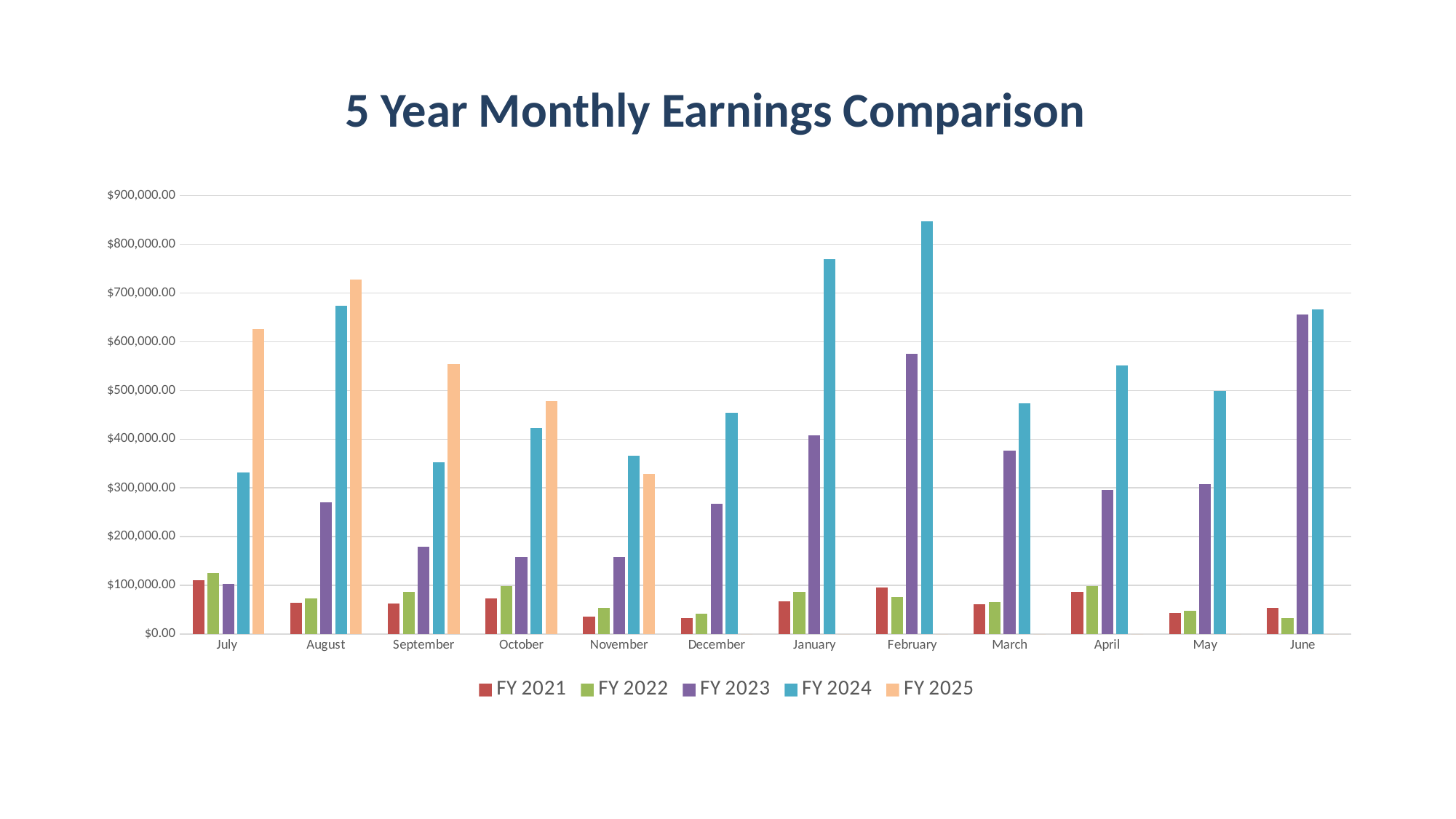
What kind of chart is shown on the slide? Bar chart Is the FY 2024 value for February greater or less than $800,000.00? greater In which month is the FY 2025 bar the highest? August Is the FY 2023 value for June greater or less than $600,000.00? greater For how many months does the chart show an FY 2025 bar? 5 In which month is the FY 2024 bar the highest? February How many series does the legend list? 5 Is the FY 2025 value for August greater or less than $700,000.00? greater In which month is the FY 2025 bar the lowest? November In July, which is larger: the FY 2024 value or the FY 2025 value? FY 2025 What is the title of the chart? 5 Year Monthly Earnings Comparison How many months are shown along the x axis? 12